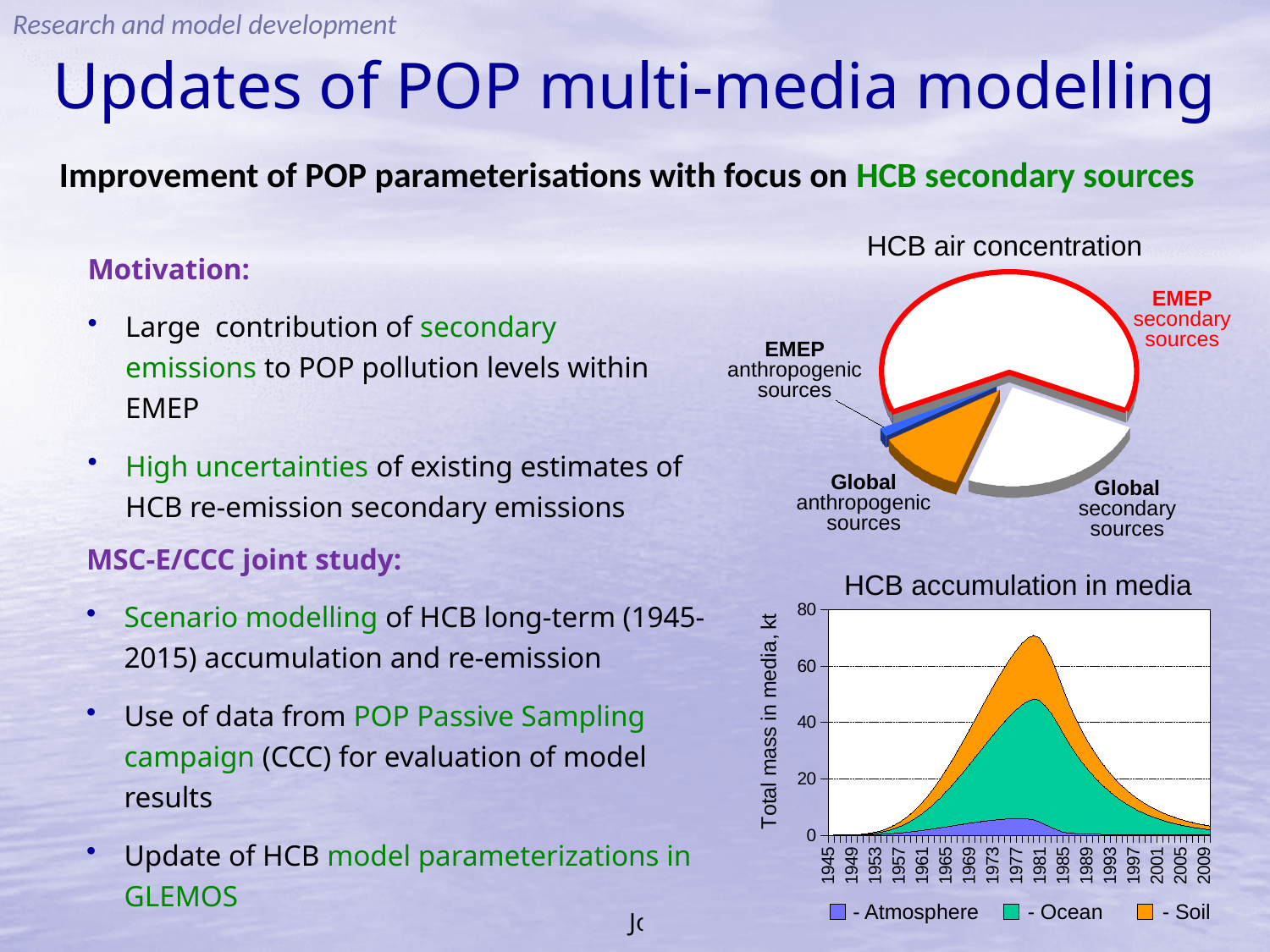
In the 'HCB accumulation in media' chart, does the total mass rise or fall from 1981 to 2009? Fall In the 'HCB air concentration' pie chart, which slice is larger: Global anthropogenic sources or EMEP anthropogenic sources? Global anthropogenic sources In the 'HCB air concentration' pie chart, which source category has the smallest slice? EMEP anthropogenic sources In the 'HCB accumulation in media' chart, is the total mass in 1945 greater or less than 20? less In the 'HCB air concentration' pie chart, which source category has the largest slice? EMEP secondary sources What is the y-axis label of the 'HCB accumulation in media' chart? Total mass in media, kt In the 'HCB air concentration' pie chart, which slice is outlined in red? EMEP secondary sources What kind of chart is the 'HCB air concentration' chart? Pie chart How many slices does the 'HCB air concentration' pie chart have? 4 How many series does the legend of the 'HCB accumulation in media' chart list? 3 In the 'HCB accumulation in media' chart, is the peak total mass around 1981 greater or less than 60? greater What kind of chart is the 'HCB accumulation in media' chart? Stacked area chart